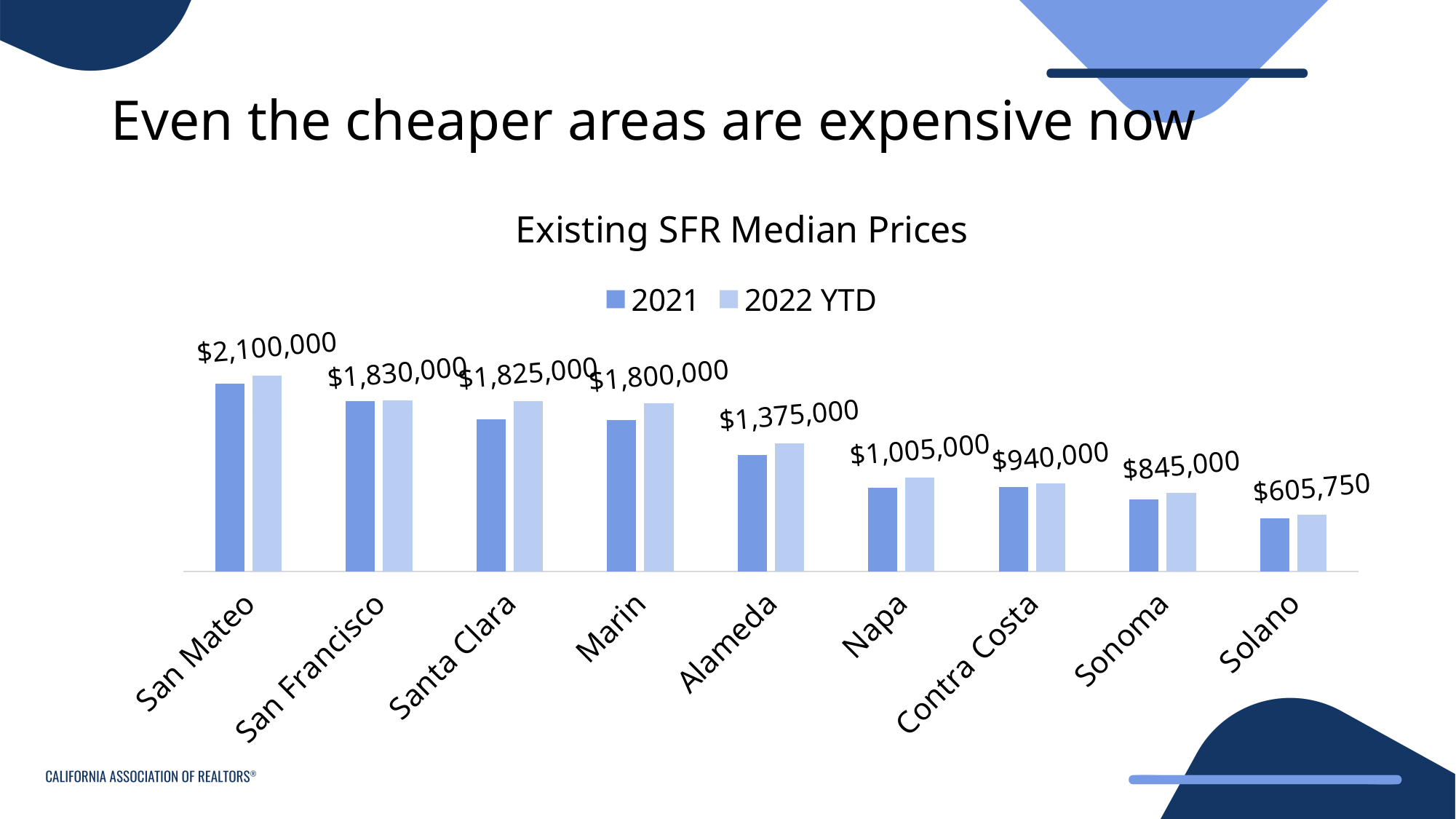
What is the 2022 YTD median price for Solano? $605,750 What is the difference between the 2022 YTD median prices of Napa and Sonoma? $160,000 What is the 2022 YTD median price for Alameda? $1,375,000 What kind of chart is shown on the slide? Bar chart How many counties are shown on the x axis? 9 What is the difference between the 2022 YTD median prices of San Mateo and Solano? $1,494,250 For Santa Clara, which is larger: the 2021 bar or the 2022 YTD bar? 2022 YTD How many series does the legend list? 2 Which county has the lowest 2022 YTD median price? Solano What is the 2022 YTD median price for Contra Costa? $940,000 Which county has the highest 2022 YTD median price? San Mateo What is the 2022 YTD median price for San Mateo? $2,100,000